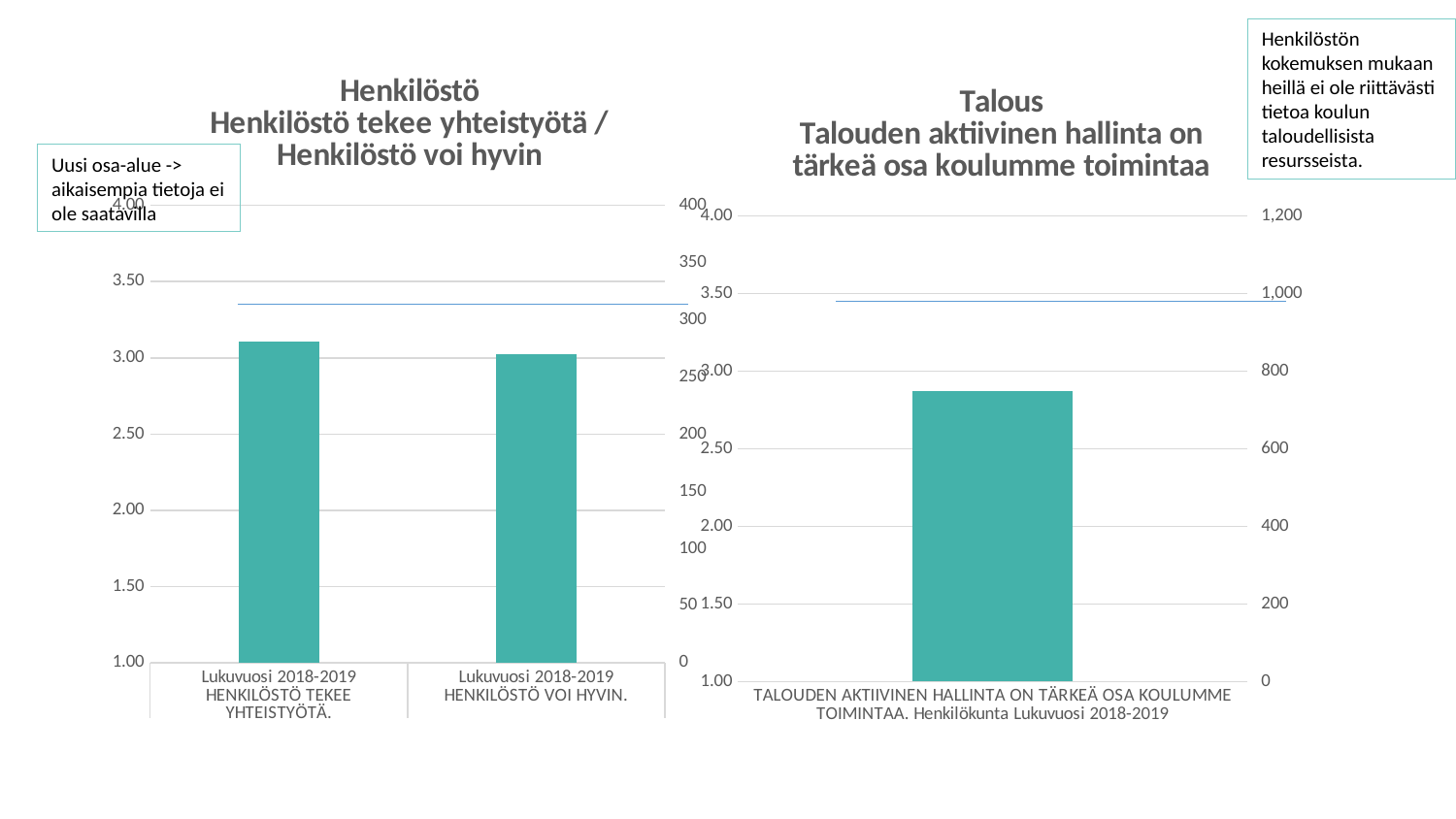
What is the highest tick value shown on the right-hand axis of the right chart titled "Talous"? 1,200 How many bars are plotted in the left chart titled "Henkilöstö"? 2 In the left chart titled "Henkilöstö", is the value for "Lukuvuosi 2018-2019 HENKILÖSTÖ VOI HYVIN." greater or less than 3.50? less What kind of chart is the left chart titled "Henkilöstö"? combination bar and line chart In the left chart titled "Henkilöstö", which bar is taller: "HENKILÖSTÖ TEKEE YHTEISTYÖTÄ." or "HENKILÖSTÖ VOI HYVIN."? HENKILÖSTÖ TEKEE YHTEISTYÖTÄ. What is the highest tick value shown on the left axis of the left chart titled "Henkilöstö"? 4.00 How many bars are plotted in the right chart titled "Talous"? 1 In the right chart titled "Talous", is the value of the bar greater or less than 3.00 on the left axis? less What kind of chart is the right chart titled "Talous"? combination bar and line chart In the right chart titled "Talous", is the value of the bar greater or less than 2.50 on the left axis? greater